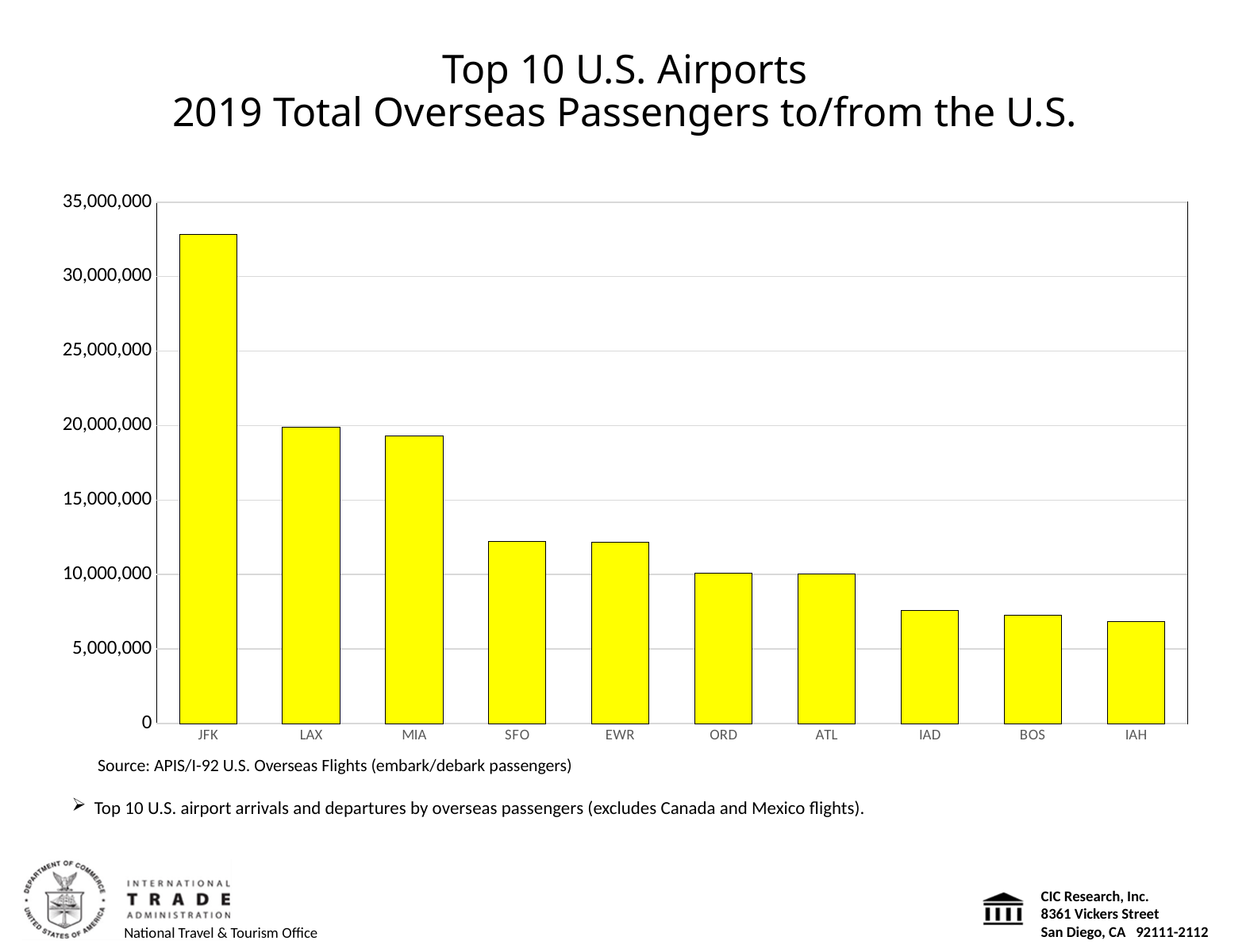
Is the value for MIA greater or less than 20,000,000? less Which airport has the lowest number of overseas passengers? IAH Is the value for IAH greater or less than 5,000,000? greater Which has more overseas passengers, MIA or SFO? MIA What is the title of the chart? Top 10 U.S. Airports 2019 Total Overseas Passengers to/from the U.S. Do the values rise or fall moving from left to right along the x axis? Fall Which airport has the highest number of overseas passengers? JFK What kind of chart is shown on the slide? Bar chart Is the value for SFO greater or less than 10,000,000? greater How many airports are shown on the chart? 10